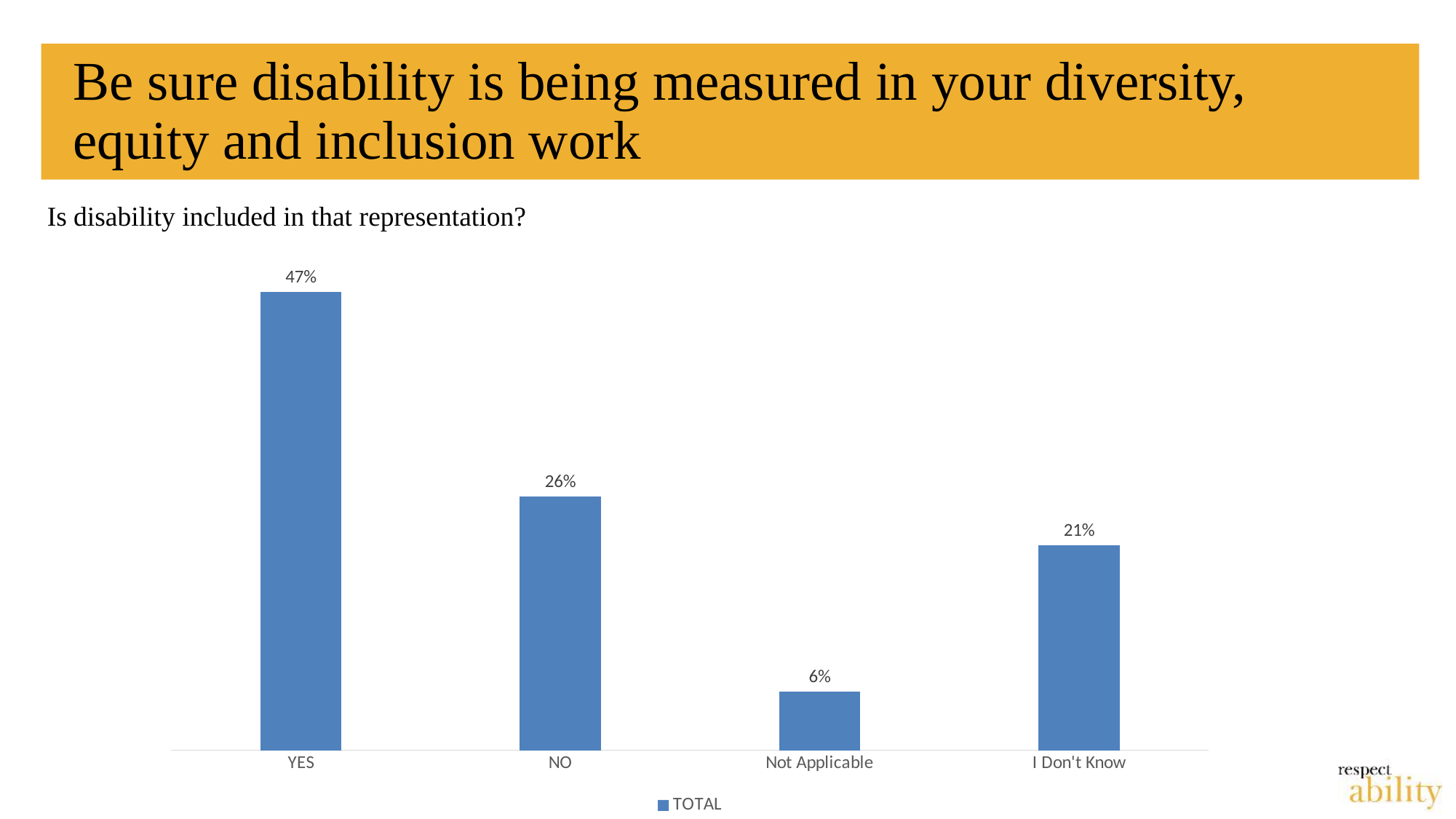
Which is larger, the value for NO or the value for I Don't Know? NO What is the difference between the values for NO and I Don't Know? 5% What kind of chart is shown on the slide? Bar chart What is the value for NO? 26% What is the difference between the values for YES and NO? 21% Which category has the lowest value? Not Applicable What is the value for I Don't Know? 21% What is the value for Not Applicable? 6% What series name does the legend list? TOTAL How many categories are shown on the x axis? 4 Which category has the highest value? YES What is the value for YES? 47%